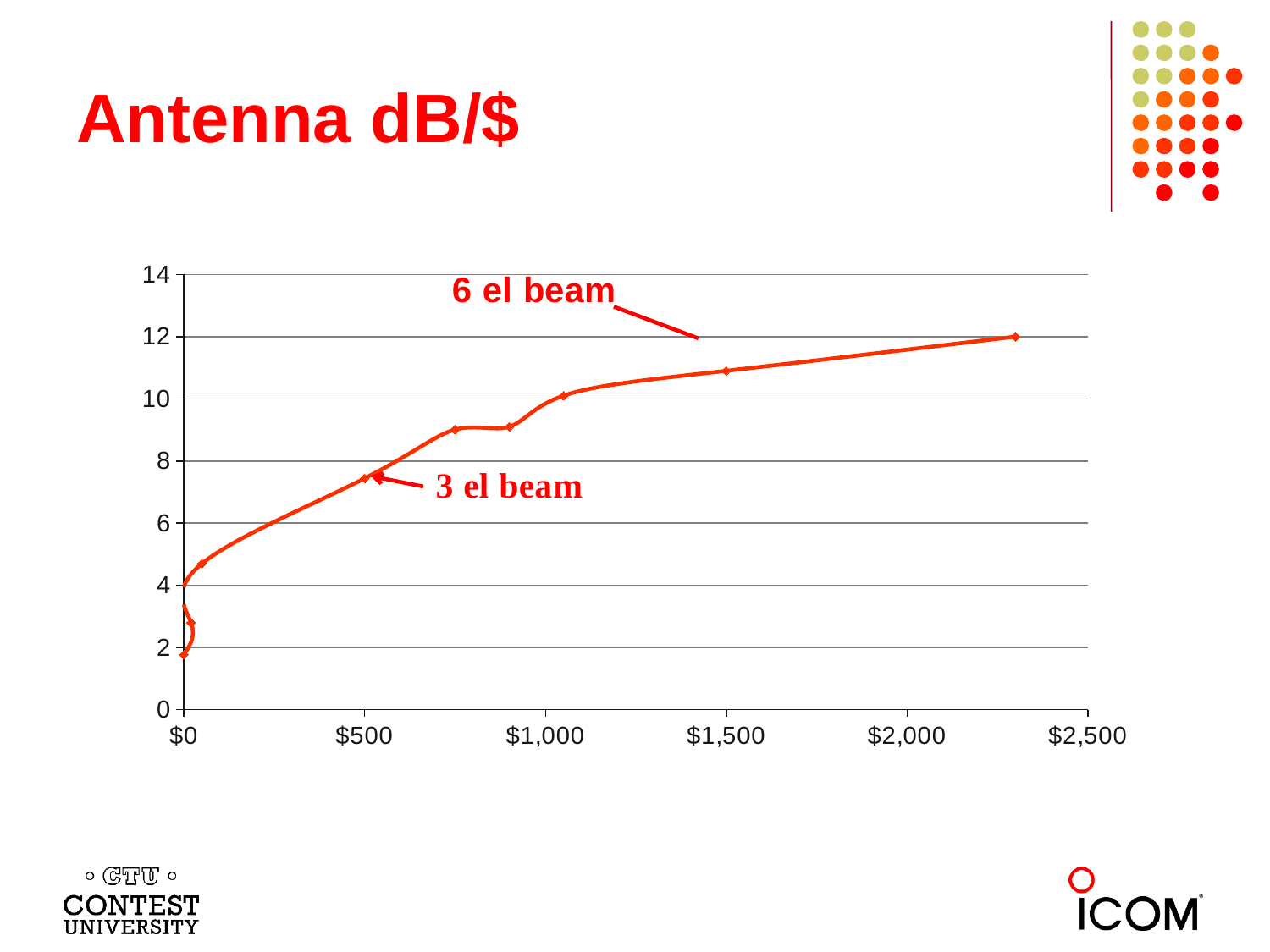
What kind of chart is shown on the slide? line chart What is the highest tick value shown on the x axis? $2,500 Is the value at $1,500 larger or smaller than the value at $500? larger Does the line generally rise or fall as the dollar amount increases along the x axis? rise Which two antenna types are labelled with annotations on the chart? 6 el beam and 3 el beam What is the title of the slide containing the chart? Antenna dB/$ Is the value of the line at $500 greater or less than 8? less Is the value of the line at $1,000 greater or less than 12? less At which end of the x axis does the line reach its highest value? right end Is the value of the rightmost point on the line greater or less than 10? greater